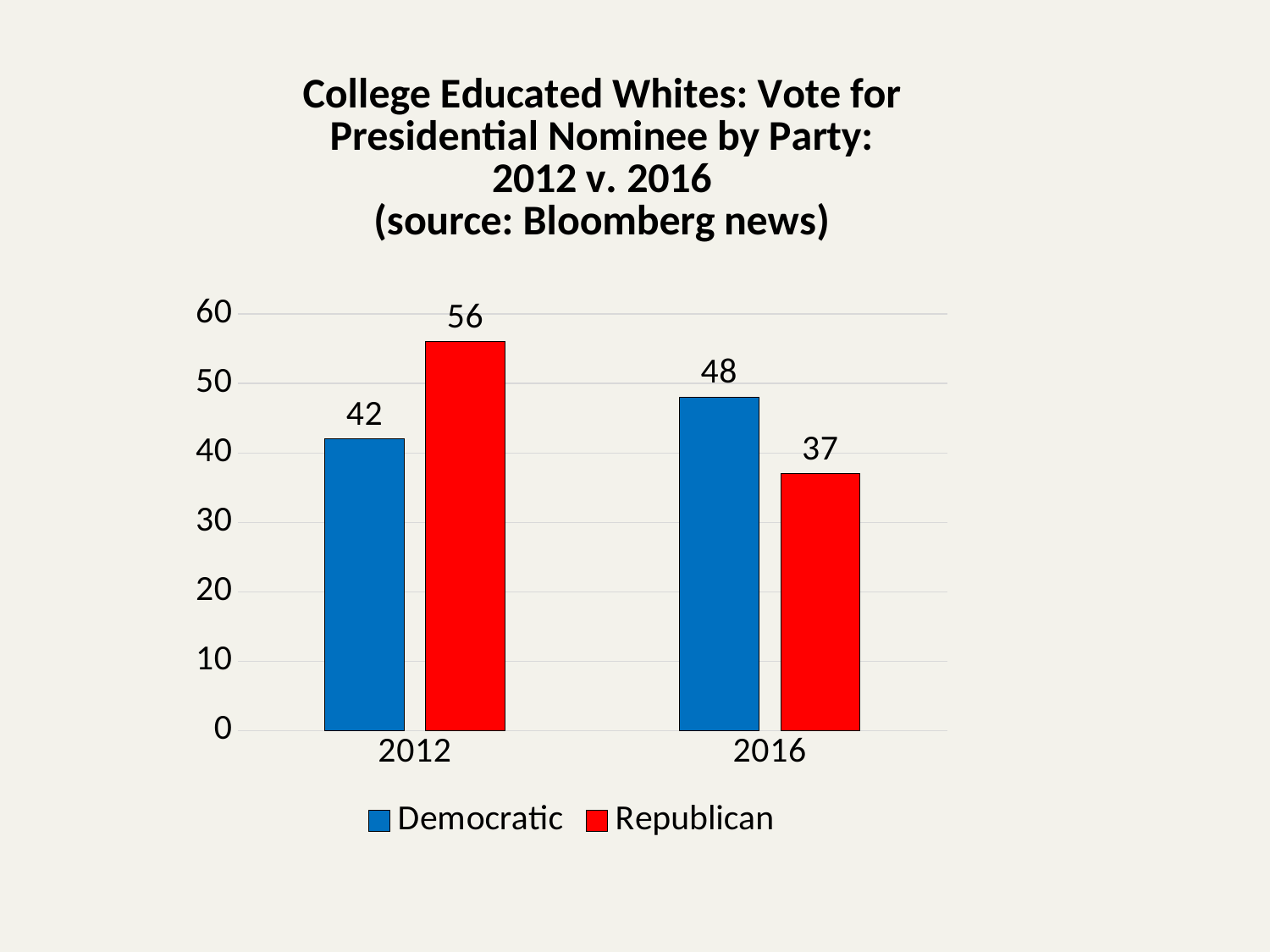
How many series does the legend list? 2 Which series has the highest value in 2012? Republican Which is larger, the Democratic value for 2012 or the Democratic value for 2016? 2016 How many years are shown on the x axis? 2 What is the Republican value for 2012? 56 What is the difference between the Republican values for 2012 and 2016? 19 What kind of chart is this? Bar chart Does the Democratic value rise or fall from 2012 to 2016? Rise What is the Democratic value for 2012? 42 Which series has the lowest value in 2016? Republican What is the Republican value for 2016? 37 What is the difference between the Democratic and Republican values in 2016? 11